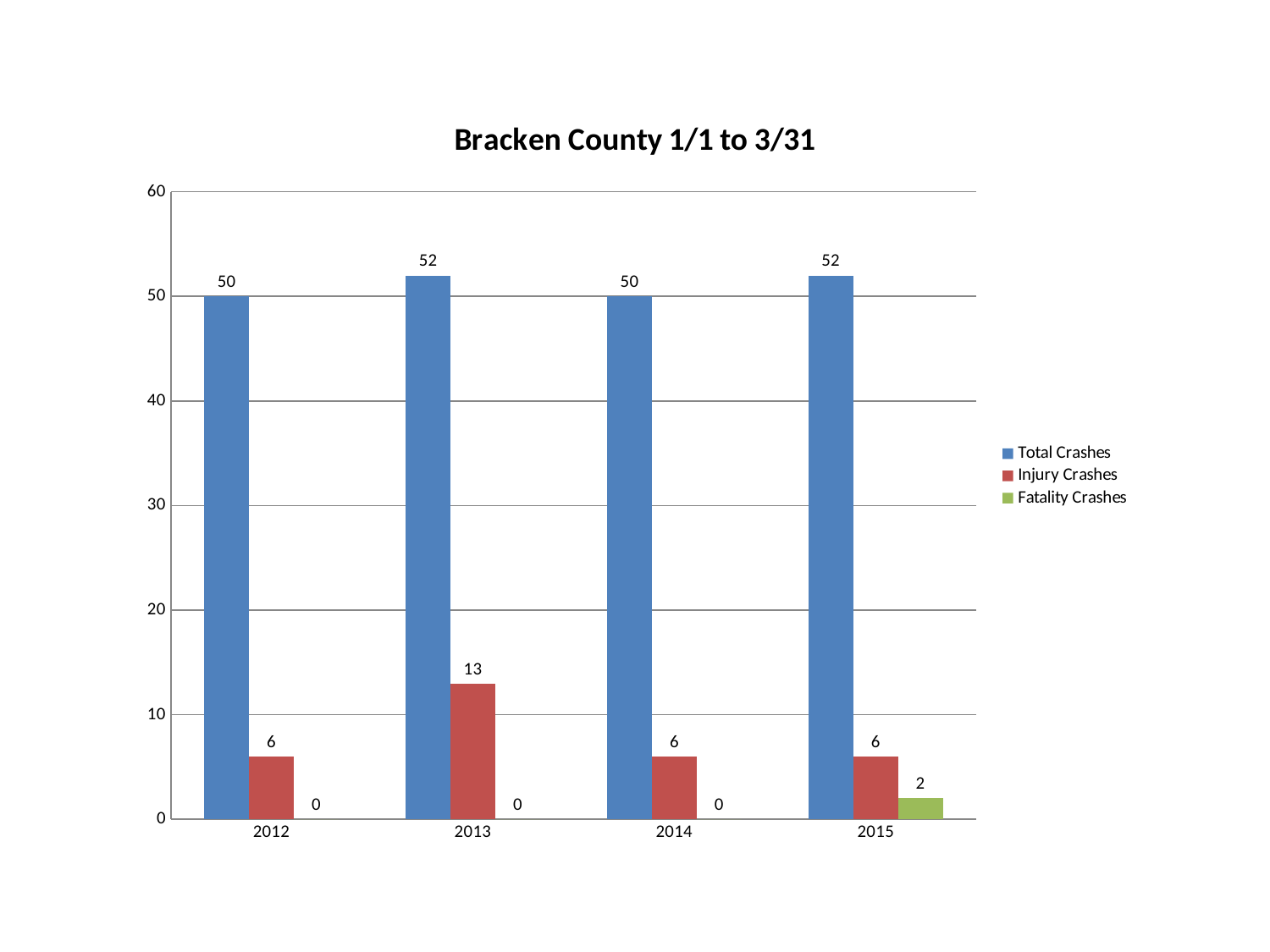
What is the title of the chart? Bracken County 1/1 to 3/31 Which year has the highest Injury Crashes value? 2013 What kind of chart is shown on the slide? Bar chart What is the value of Injury Crashes for 2013? 13 How many years are shown on the x axis? 4 Is the value of Total Crashes for 2012 greater or less than 40? greater What is the difference between Total Crashes and Injury Crashes in 2014? 44 Which is larger, Injury Crashes in 2013 or Injury Crashes in 2015? Injury Crashes in 2013 What is the value of Injury Crashes for 2012? 6 What is the value of Total Crashes for 2013? 52 How many series does the legend list? 3 What is the value of Fatality Crashes for 2015? 2